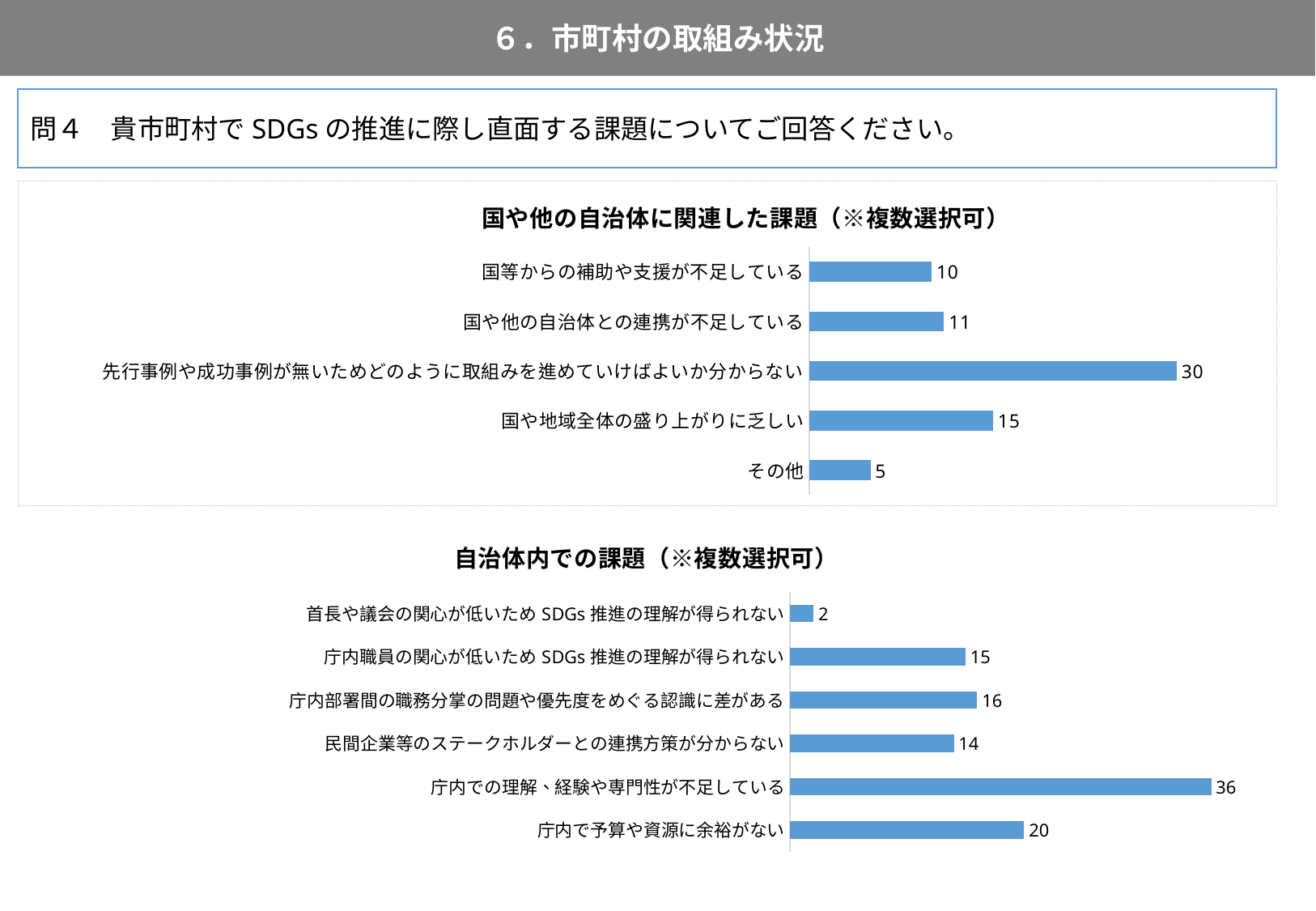
In the chart titled 自治体内での課題（※複数選択可）, what is the value for 庁内で予算や資源に余裕がない? 20 In the chart titled 自治体内での課題（※複数選択可）, how many categories are shown? 6 In the chart titled 自治体内での課題（※複数選択可）, which category has the highest value? 庁内での理解、経験や専門性が不足している In the chart titled 国や他の自治体に関連した課題（※複数選択可）, which category has the lowest value? その他 What type of chart is the chart titled 自治体内での課題（※複数選択可）? Bar chart In the chart titled 国や他の自治体に関連した課題（※複数選択可）, what is the value for 国や地域全体の盛り上がりに乏しい? 15 In the chart titled 自治体内での課題（※複数選択可）, which is larger: 庁内部署間の職務分掌の問題や優先度をめぐる認識に差がある or 民間企業等のステークホルダーとの連携方策が分からない? 庁内部署間の職務分掌の問題や優先度をめぐる認識に差がある In the chart titled 自治体内での課題（※複数選択可）, which category has the lowest value? 首長や議会の関心が低いため SDGs 推進の理解が得られない In the chart titled 国や他の自治体に関連した課題（※複数選択可）, what is the value for 先行事例や成功事例が無いためどのように取組みを進めていけばよいか分からない? 30 In the chart titled 国や他の自治体に関連した課題（※複数選択可）, how many categories are shown? 5 In the chart titled 国や他の自治体に関連した課題（※複数選択可）, what is the difference between 国や他の自治体との連携が不足している and 国等からの補助や支援が不足している? 1 In the chart titled 自治体内での課題（※複数選択可）, what is the value for 庁内での理解、経験や専門性が不足している? 36